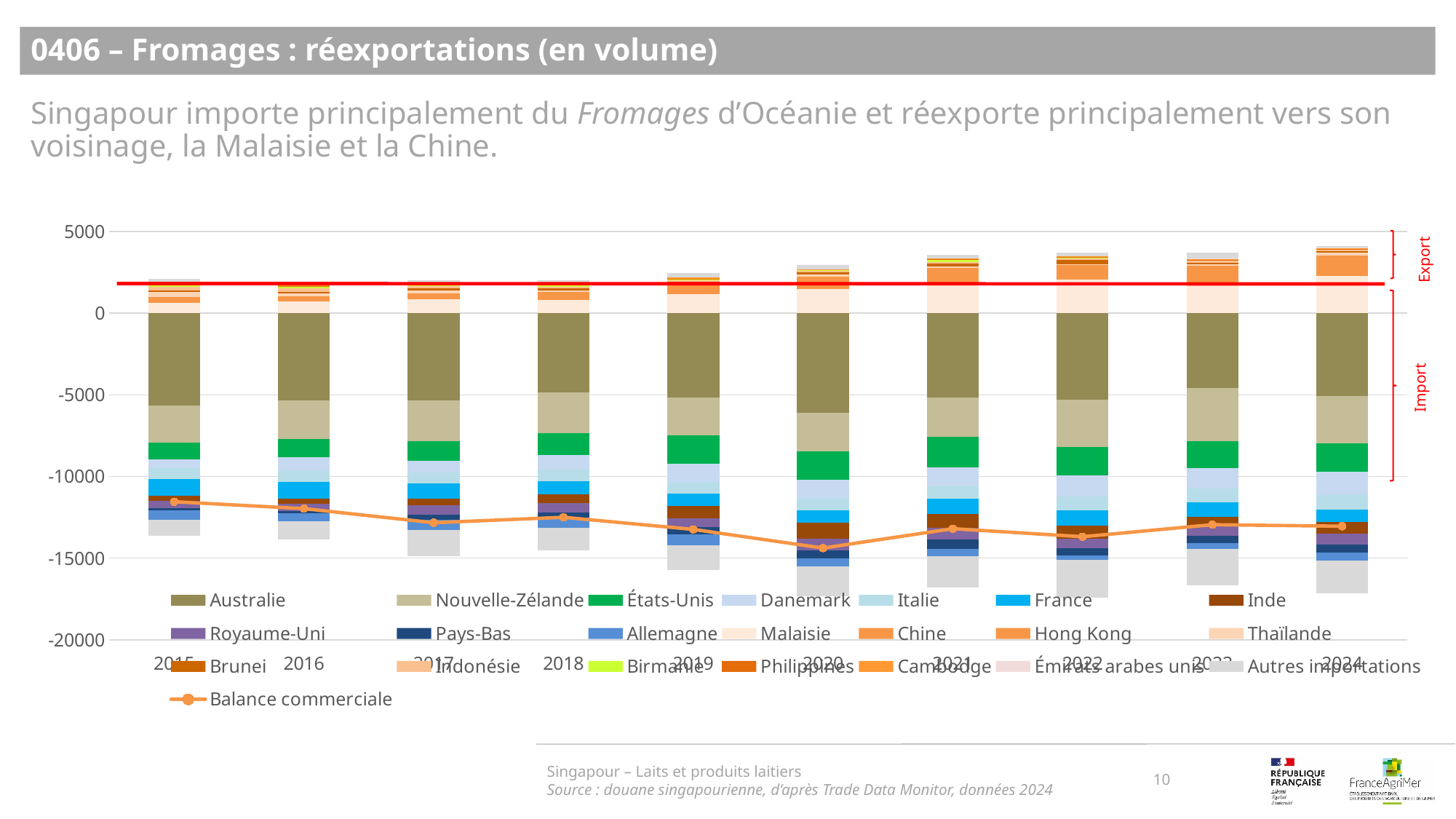
Which legend entry is plotted as a line with markers rather than as bars? Balance commerciale Is the Balance commerciale value for 2020 greater or less than -10000? less Which year has the larger total export (positive) stacked bar, 2015 or 2024? 2024 Does the Balance commerciale line rise or fall between 2015 and 2020? fall How many years are shown along the x axis of the chart? 10 How many entries does the chart legend list? 22 In which year is the Balance commerciale line at its lowest point? 2020 What kind of chart is shown on the slide? Stacked bar chart with a line Is the top of the export (positive) stacked bar for 2015 greater or less than 3000? less Is the top of the export (positive) stacked bar for 2024 greater or less than 3000? greater What two labels are written in red on the right side of the chart to mark the positive and negative parts of the bars? Export and Import